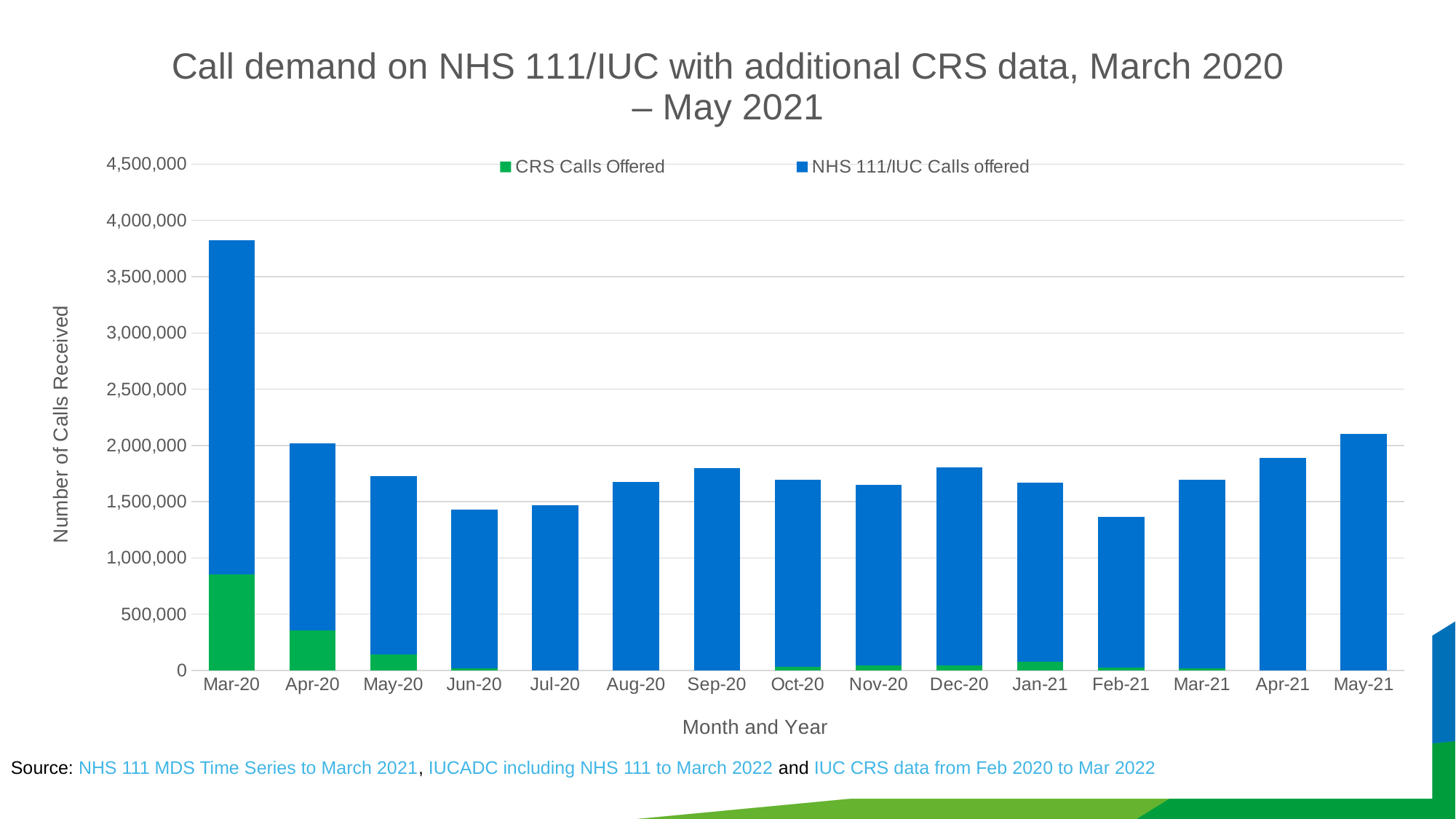
Is the value for CRS Calls Offered in Mar-20 greater or less than 500,000? greater Which month has the highest number of CRS Calls Offered? Mar-20 How many months are plotted along the x axis? 15 Which month has the larger total number of calls, Apr-21 or Mar-21? Apr-21 How many series does the legend list? 2 What kind of chart is shown on the slide? Stacked bar chart Is the total number of calls for Feb-21 greater or less than 1,500,000? less Do the total calls rise or fall from Feb-21 to May-21? Rise What colour represents CRS Calls Offered in the chart? Green Do the total calls rise or fall from Mar-20 to Jun-20? Fall Which month has the highest total number of calls? Mar-20 Is the total number of calls for Mar-20 greater or less than 3,500,000? greater